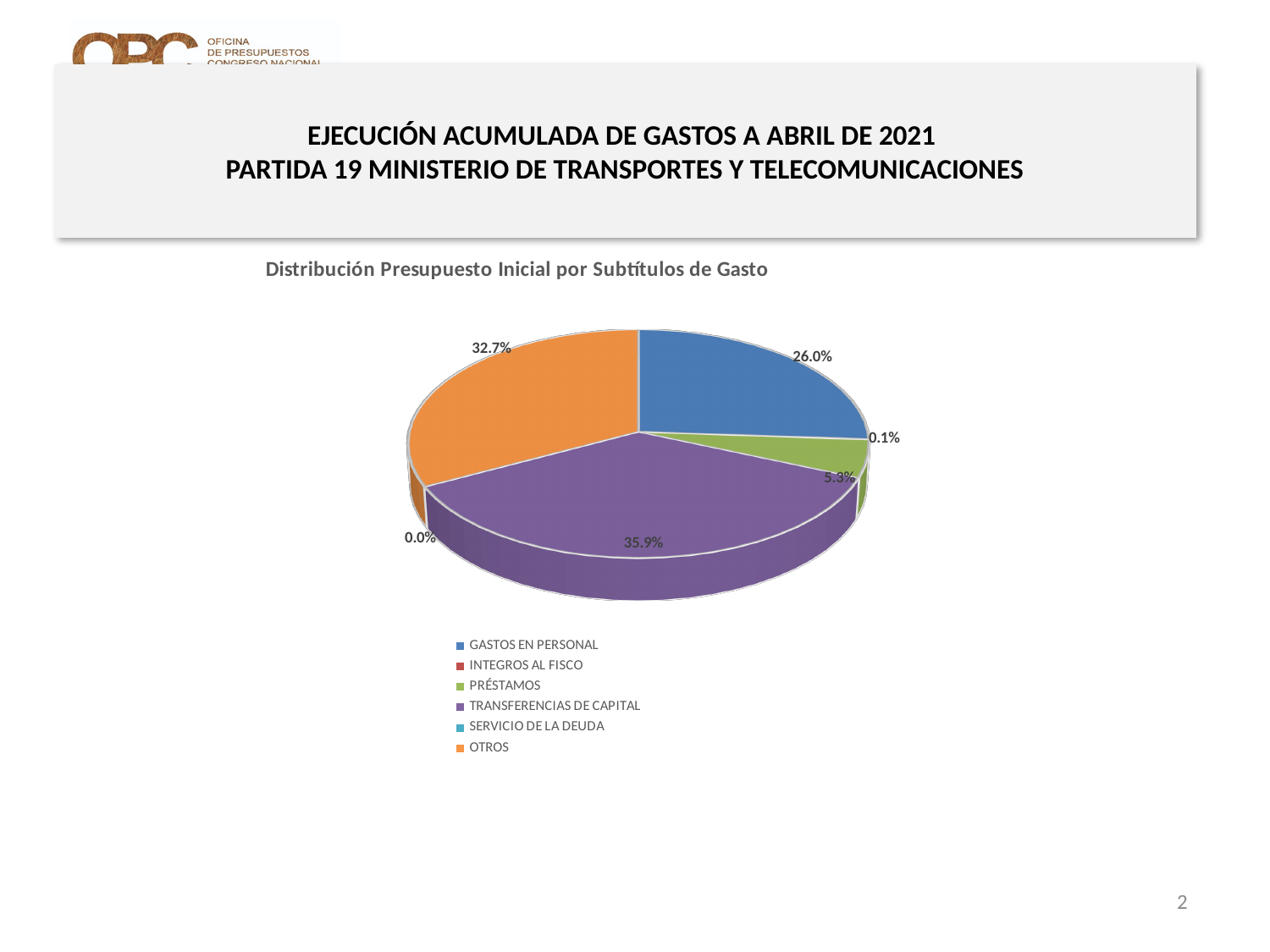
How many categories does the legend list? 6 Which category has the largest share of the pie? TRANSFERENCIAS DE CAPITAL What is the difference between the shares of GASTOS EN PERSONAL and PRÉSTAMOS? 20.7 percentage points What percentage is shown for PRÉSTAMOS? 5.3% What share of the initial budget goes to TRANSFERENCIAS DE CAPITAL? 35.9% What kind of chart is shown on the slide? Pie chart What percentage is shown for INTEGROS AL FISCO? 0.1% Which is larger, the share for OTROS or the share for GASTOS EN PERSONAL? OTROS What percentage is shown for GASTOS EN PERSONAL? 26.0% What percentage is shown for OTROS? 32.7% What is the title of the pie chart? Distribución Presupuesto Inicial por Subtítulos de Gasto How many percentage points larger is TRANSFERENCIAS DE CAPITAL than OTROS? 3.2 percentage points